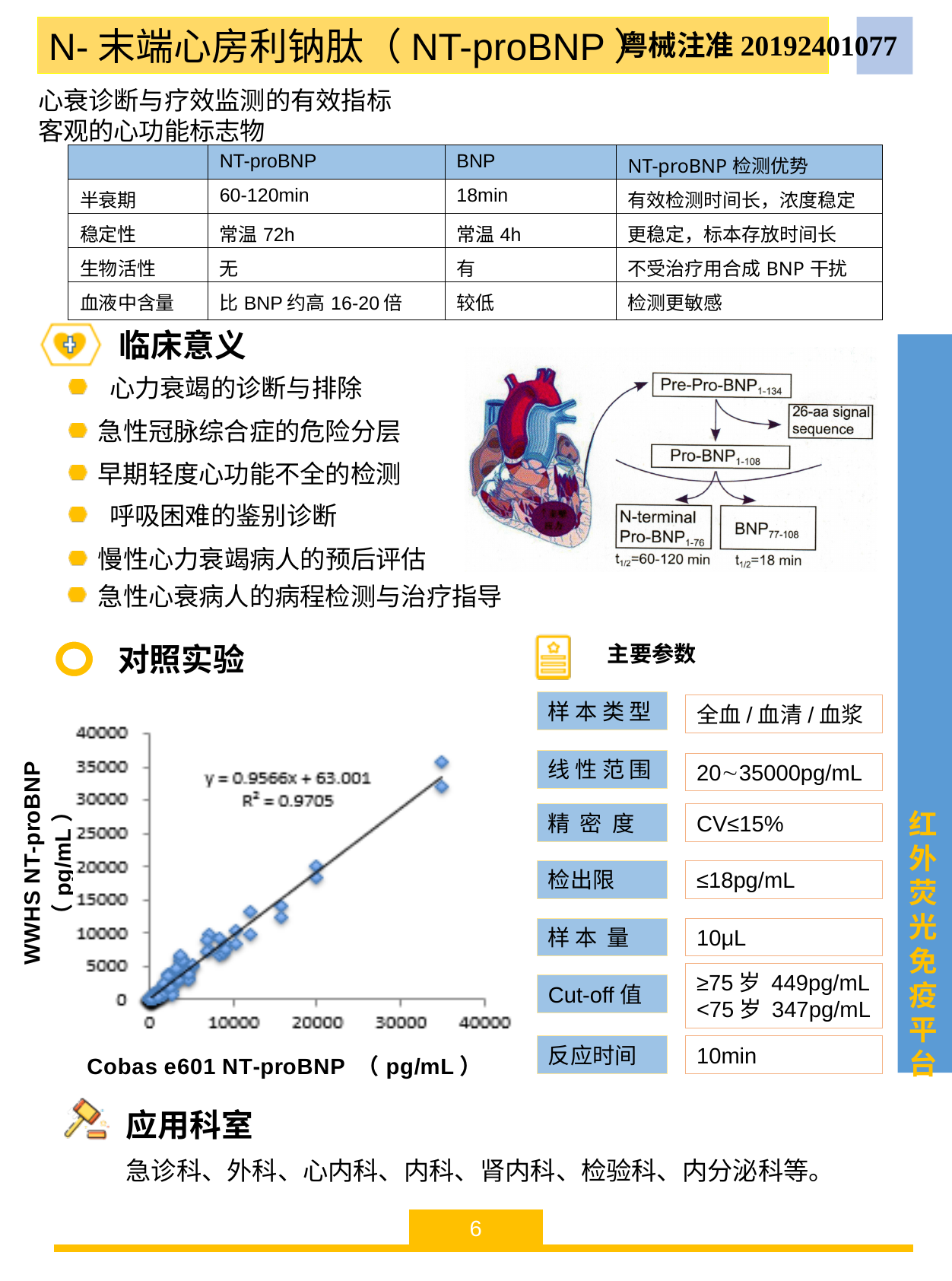
Is the slope of the fitted line in the scatter chart greater or less than 1? less What is the regression equation printed on the scatter chart? y = 0.9566x + 63.001 Is the x value of the rightmost point in the scatter chart greater or less than 30000? greater What is the interval between consecutive tick marks on the x axis of the scatter chart? 10000 What R² value is printed on the scatter chart? 0.9705 What kind of chart is shown in the 对照实验 section? scatter chart Do the plotted points in the scatter chart rise or fall as the x value increases? rise Is the y value of the highest point in the scatter chart greater or less than 30000? greater What is the maximum value shown on the x axis of the scatter chart? 40000 What is the interval between consecutive tick marks on the y axis of the scatter chart? 5000 What is the maximum value shown on the y axis of the scatter chart? 40000 What is the label of the x axis of the scatter chart? Cobas e601 NT-proBNP (pg/mL)